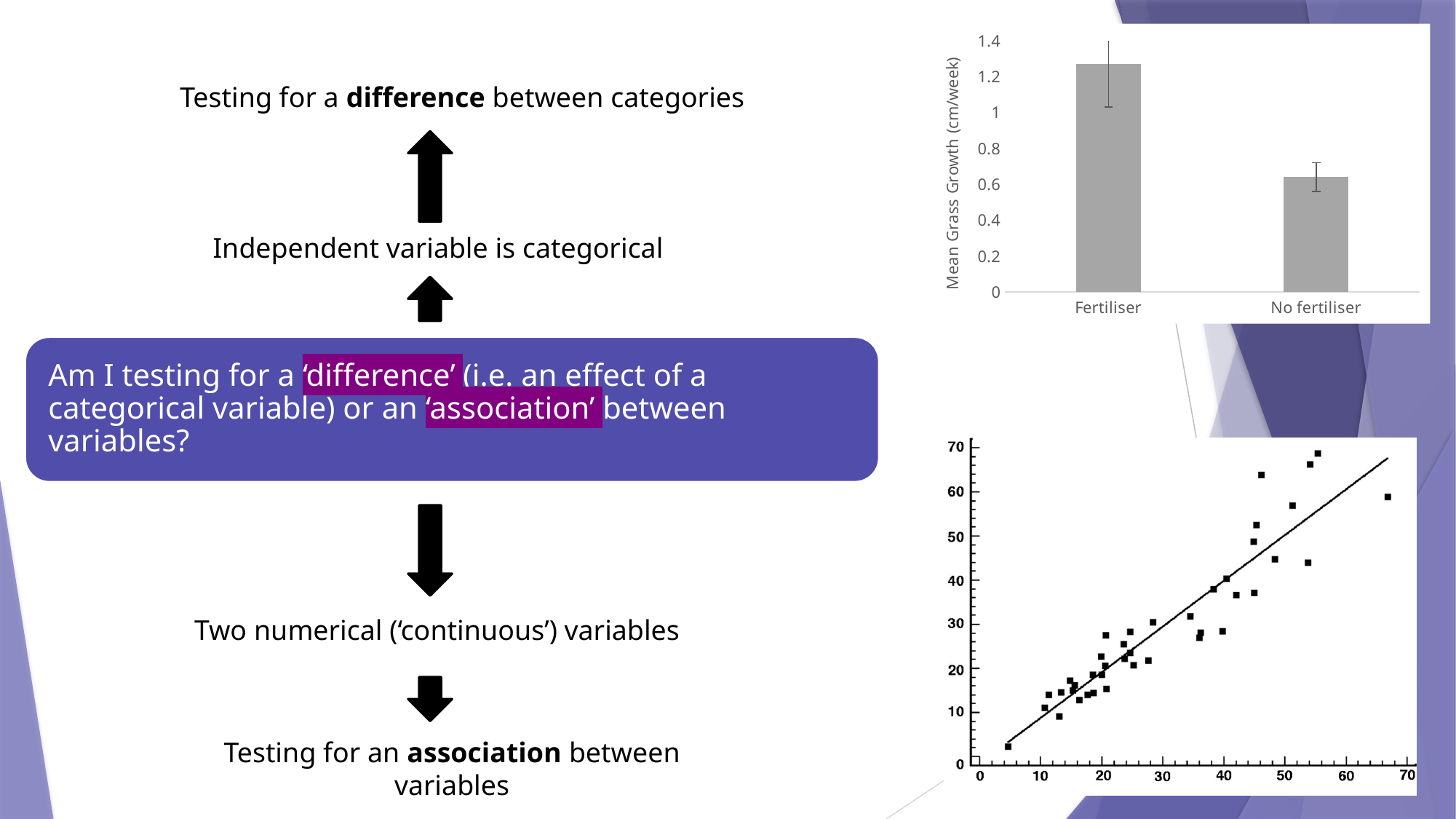
In the top-right bar chart, is the value for Fertiliser greater or less than 1? greater What kind of chart is the top-right chart on the slide? bar chart In the top-right bar chart, which category has the lower mean grass growth? No fertiliser In the top-right bar chart, is the value for No fertiliser greater or less than 0.8? less How many categories are shown in the top-right bar chart? 2 In the bottom-right scatter plot, do the values generally rise or fall as the x-axis value increases? rise In the top-right bar chart, which category has the higher mean grass growth? Fertiliser What is the y-axis label of the top-right bar chart? Mean Grass Growth (cm/week) In the top-right bar chart, is the bar for Fertiliser larger or smaller than the bar for No fertiliser? larger In the top-right bar chart, is the value for Fertiliser greater or less than 1.4? less What kind of chart is the bottom-right chart on the slide? scatter plot